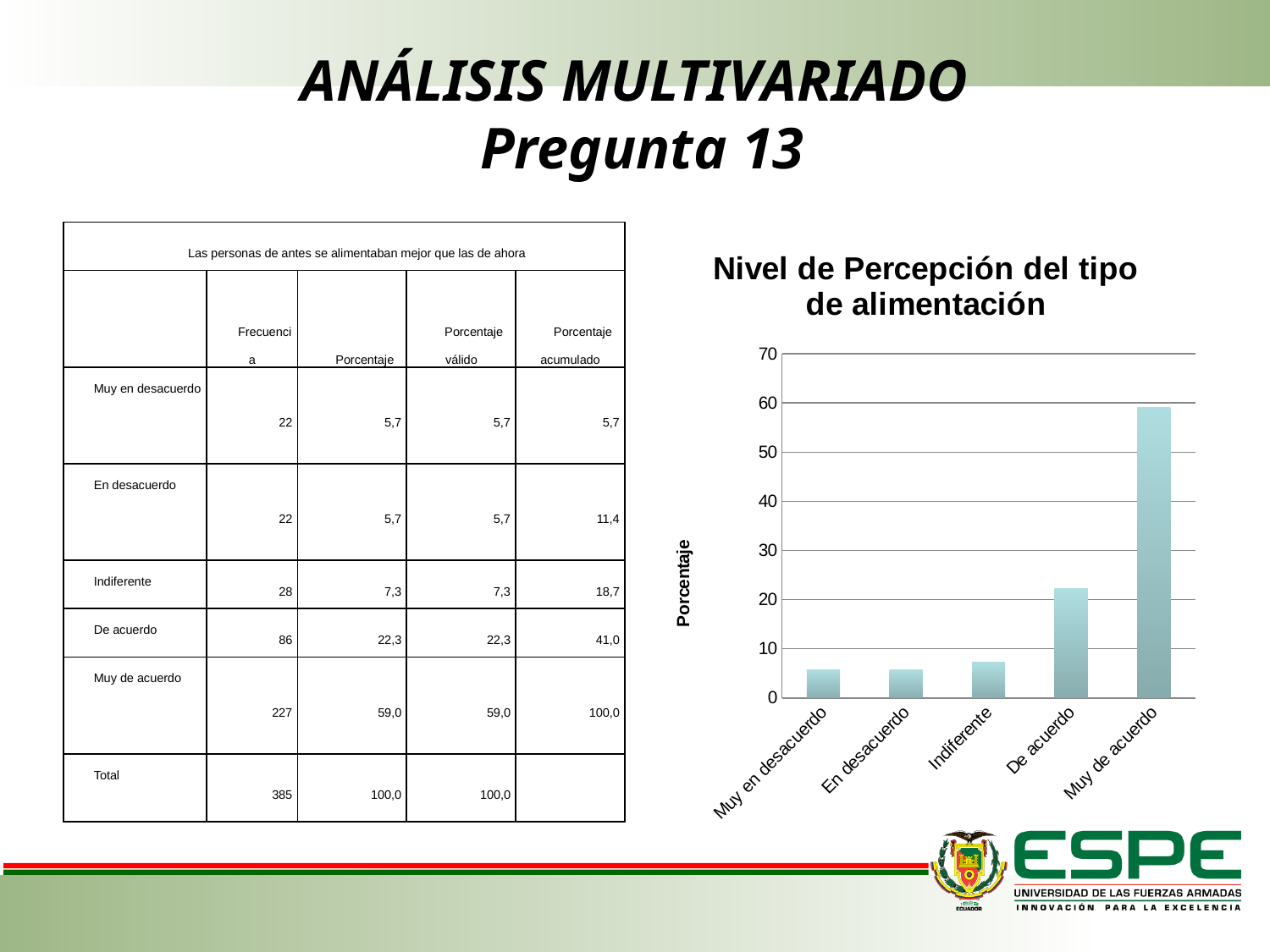
Which category has the highest bar in the chart? Muy de acuerdo What kind of chart is shown on the slide? bar chart Is the value for De acuerdo greater or less than 20? greater Is the value for Indiferente greater or less than 10? less Which is larger, the bar for De acuerdo or the bar for Indiferente? De acuerdo Is the value for Muy de acuerdo greater or less than 50? greater Do the bar values generally rise or fall from left to right along the x axis? rise What is the title of the chart? Nivel de Percepción del tipo de alimentación According to the table, what percentage corresponds to Muy de acuerdo, the tallest bar in the chart? 59,0 How many categories are shown on the x axis of the chart? 5 What is the label of the y axis of the chart? Porcentaje